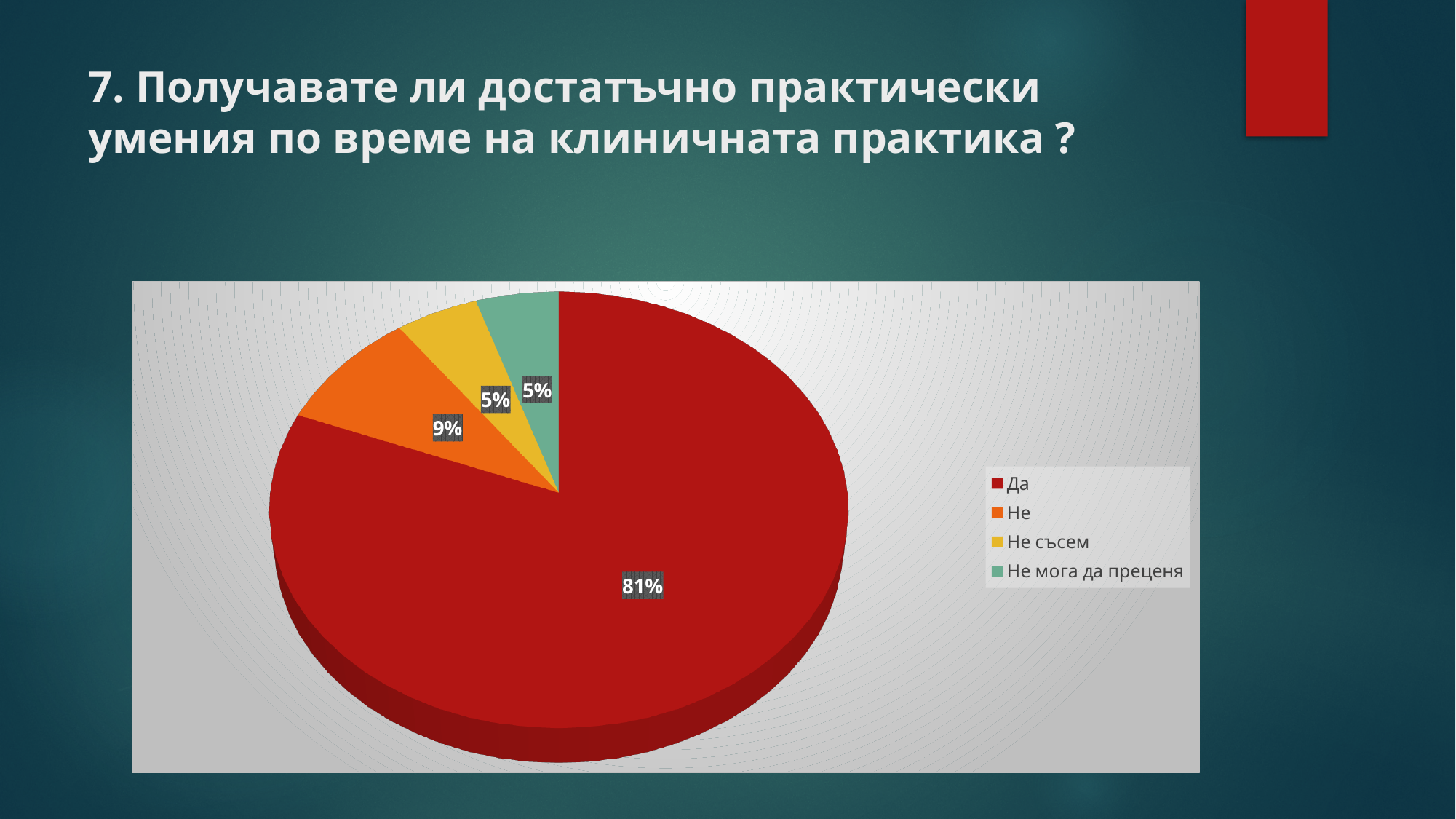
Which slice is larger, "Не" or "Не съсем"? Не How many entries does the legend list? 4 What colour is the "Да" slice in the pie chart? Red What percentage is shown for the "Не мога да преценя" slice? 5% How many slices does the pie chart have? 4 What is the combined percentage of the "Не" and "Не съсем" slices? 14% What is the difference in percentage points between the "Да" slice and the "Не" slice? 72 What percentage is shown for the "Не съсем" slice? 5% Which category has the largest slice of the pie? Да What share of the pie does the "Да" slice represent? 81% What kind of chart is shown on the slide? Pie chart What percentage is shown for the "Не" slice? 9%